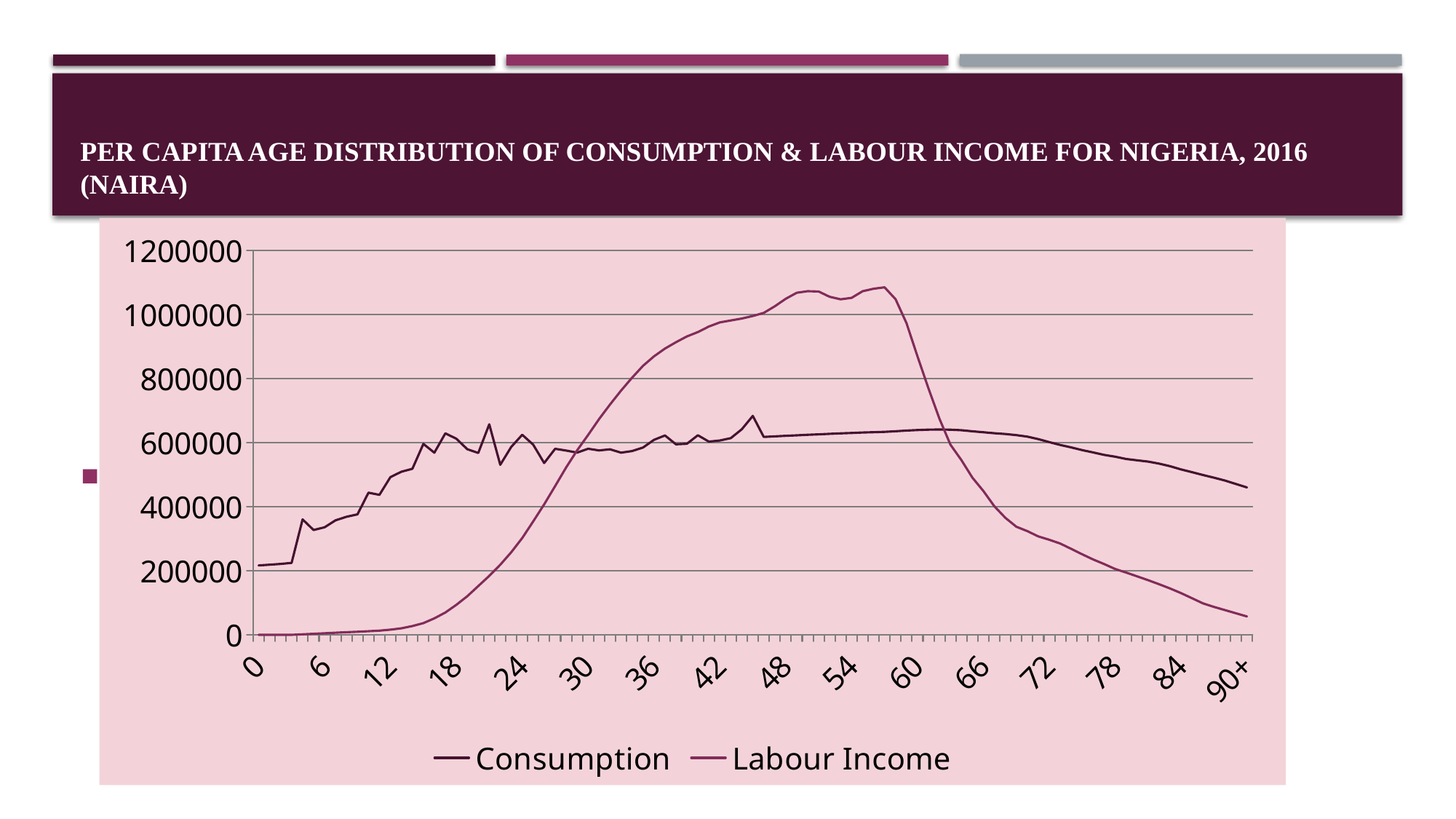
Does the Labour Income line rise or fall between age 60 and age 90+? fall Is the Labour Income value at age 54 greater or less than 1000000? greater At age 54, which series has the larger value, Consumption or Labour Income? Labour Income At age 12, which series has the larger value, Consumption or Labour Income? Consumption What is the title of the chart? Per Capita Age Distribution of Consumption & Labour Income for Nigeria, 2016 (Naira) Is the Labour Income value at age 0 greater or less than 200000? less How many series does the legend list? 2 What are the two series named in the legend? Consumption and Labour Income Which series reaches the higher peak value? Labour Income What kind of chart is shown on the slide? line chart Is the Consumption value at age 90+ greater or less than 600000? less